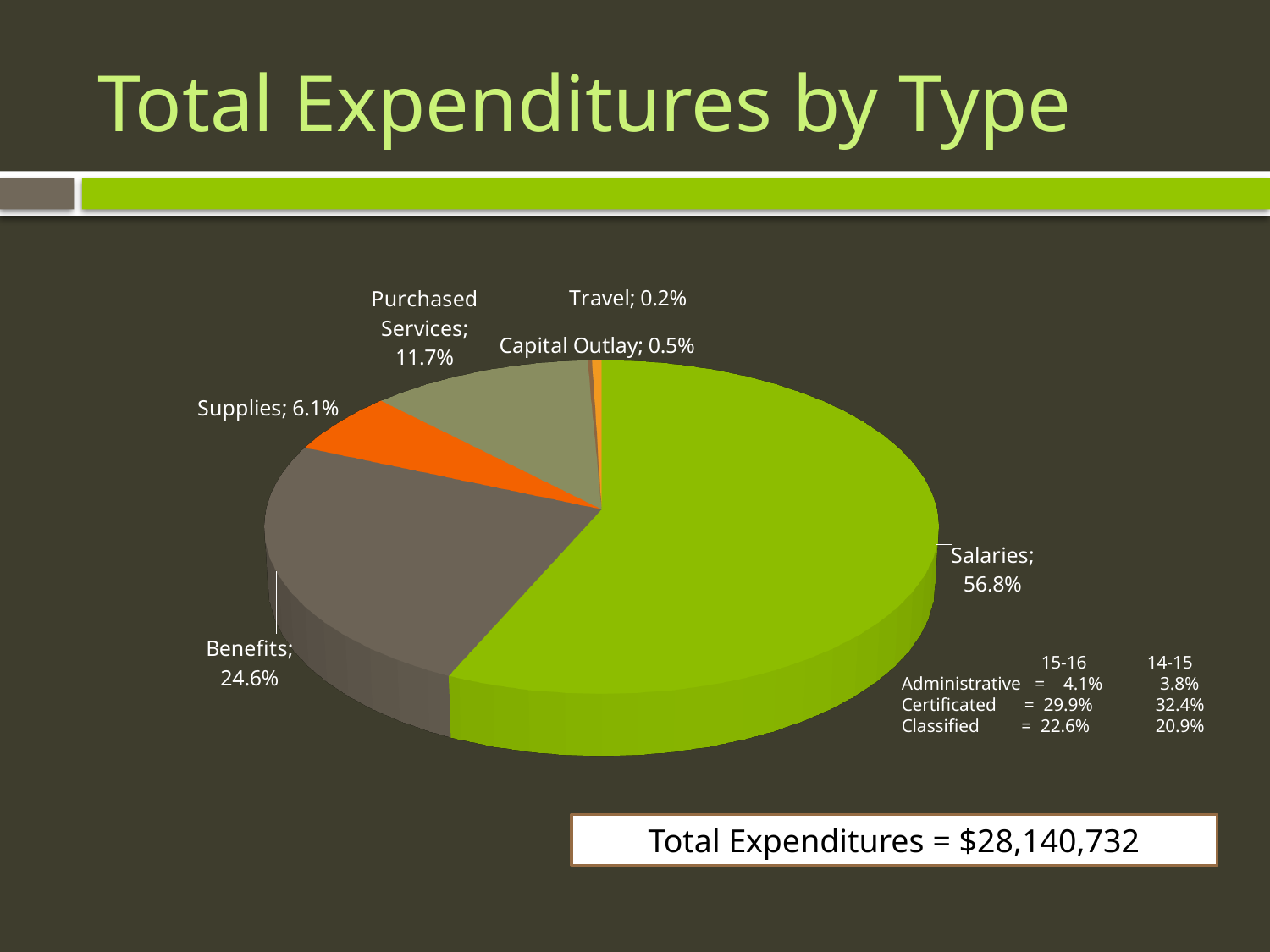
Which expenditure type has the largest share of the pie? Salaries Which expenditure type has the smallest share of the pie? Travel How many slices does the pie chart have? 6 What share of total expenditures is Capital Outlay? 0.5% What is the title of the chart on the slide? Total Expenditures by Type What kind of chart is shown on the slide? Pie chart What share of total expenditures is Supplies? 6.1% What share of total expenditures is Purchased Services? 11.7% Which is larger, the share for Supplies or the share for Purchased Services? Purchased Services What is the difference in percentage points between Salaries and Benefits? 32.2 What share of total expenditures is Benefits? 24.6% What share of total expenditures is Salaries? 56.8%